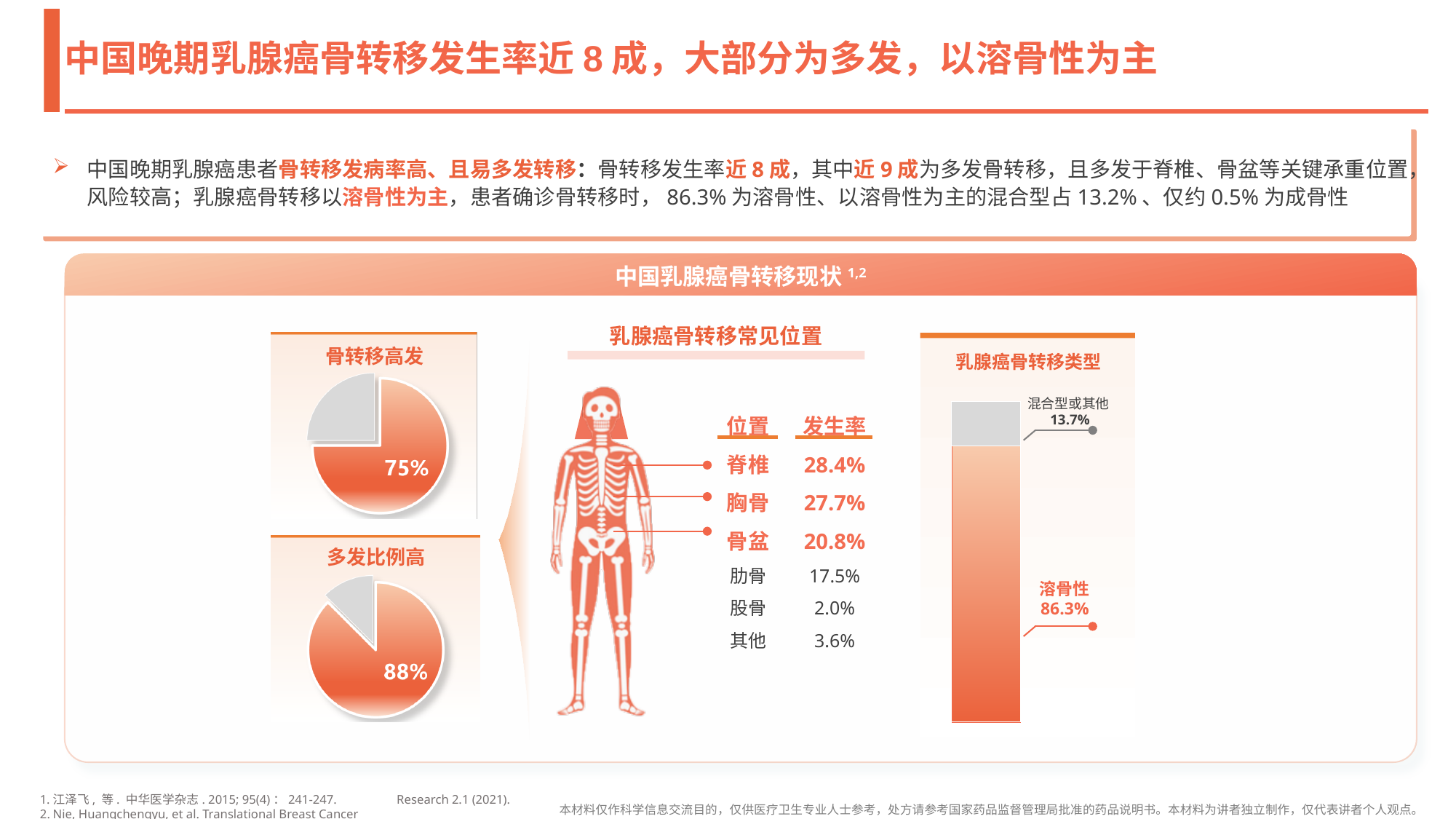
Which pie chart shows the larger highlighted share, "骨转移高发" or "多发比例高"? 多发比例高 In the "乳腺癌骨转移类型" chart, what is the difference between 溶骨性 and 混合型或其他? 72.6% In the "乳腺癌骨转移类型" chart, which segment is larger, 溶骨性 or 混合型或其他? 溶骨性 In the "多发比例高" pie chart, what percentage is shown for the highlighted orange slice? 88% In the "乳腺癌骨转移类型" chart, what is the value for 溶骨性? 86.3% In the "乳腺癌骨转移类型" chart, how many segments make up the stacked bar? 2 In the "骨转移高发" pie chart, what percentage is shown for the highlighted orange slice? 75% What is the title of the panel containing the pie charts and the bar chart? 中国乳腺癌骨转移现状 In the "乳腺癌骨转移类型" chart, what is the value for 混合型或其他? 13.7% What kind of chart is used under the heading "乳腺癌骨转移类型"? bar chart What kind of chart is used under the heading "骨转移高发"? pie chart In the "乳腺癌骨转移类型" chart, what is the total of the two stacked segments? 100%